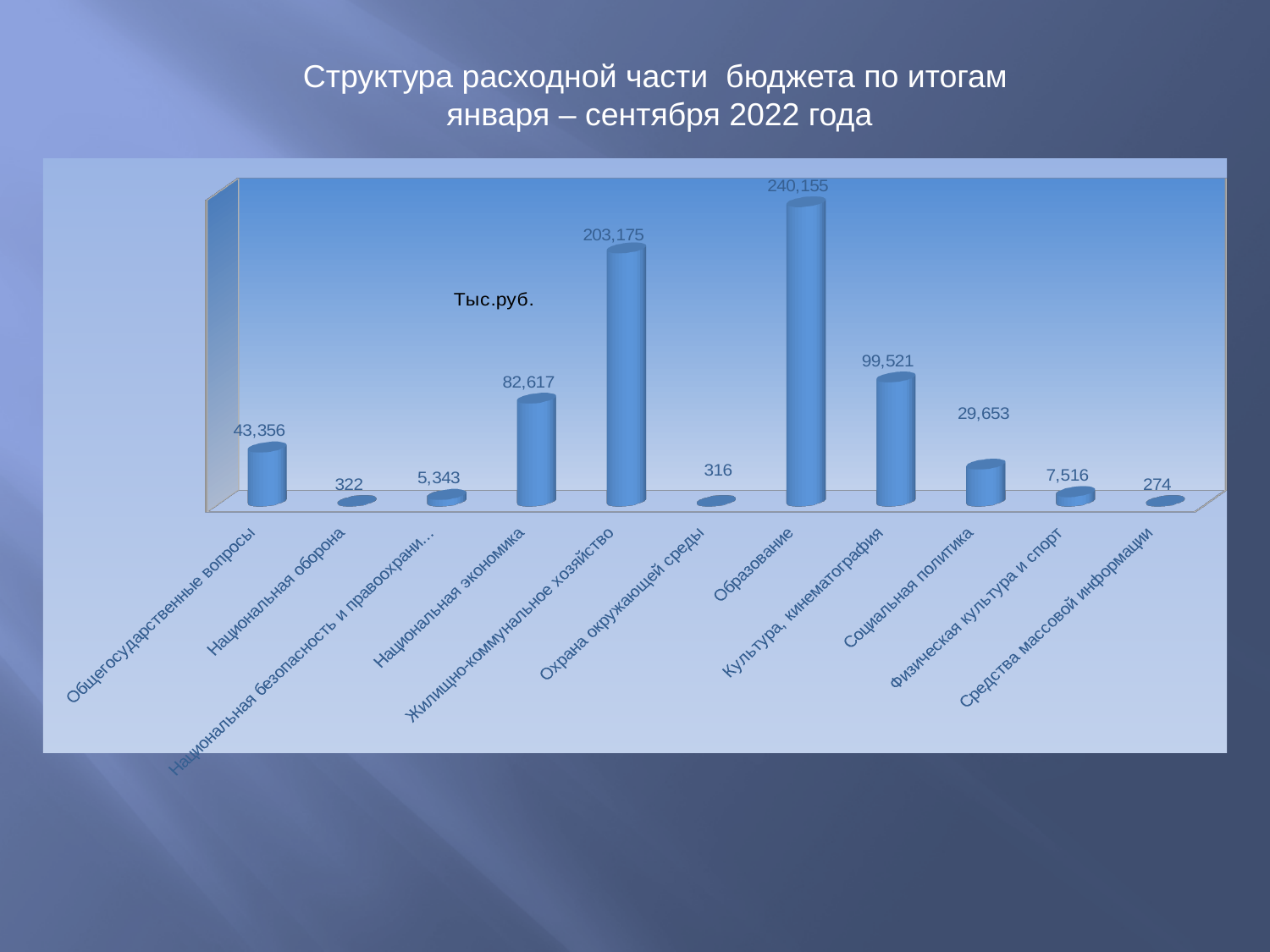
Which category has the highest value? Образование What is the difference between the values for Образование and Жилищно-коммунальное хозяйство? 36,980 What is the value for Образование? 240,155 What is the value for Социальная политика? 29,653 How many categories are shown in the chart? 11 Which is larger, the value for Общегосударственные вопросы or the value for Социальная политика? Общегосударственные вопросы What is the difference between the values for Культура, кинематография and Национальная экономика? 16,904 Which category has the lowest value? Средства массовой информации What kind of chart is shown on the slide? Bar chart What unit is indicated on the chart? Тыс.руб. What is the value for Жилищно-коммунальное хозяйство? 203,175 What is the value for Национальная оборона? 322